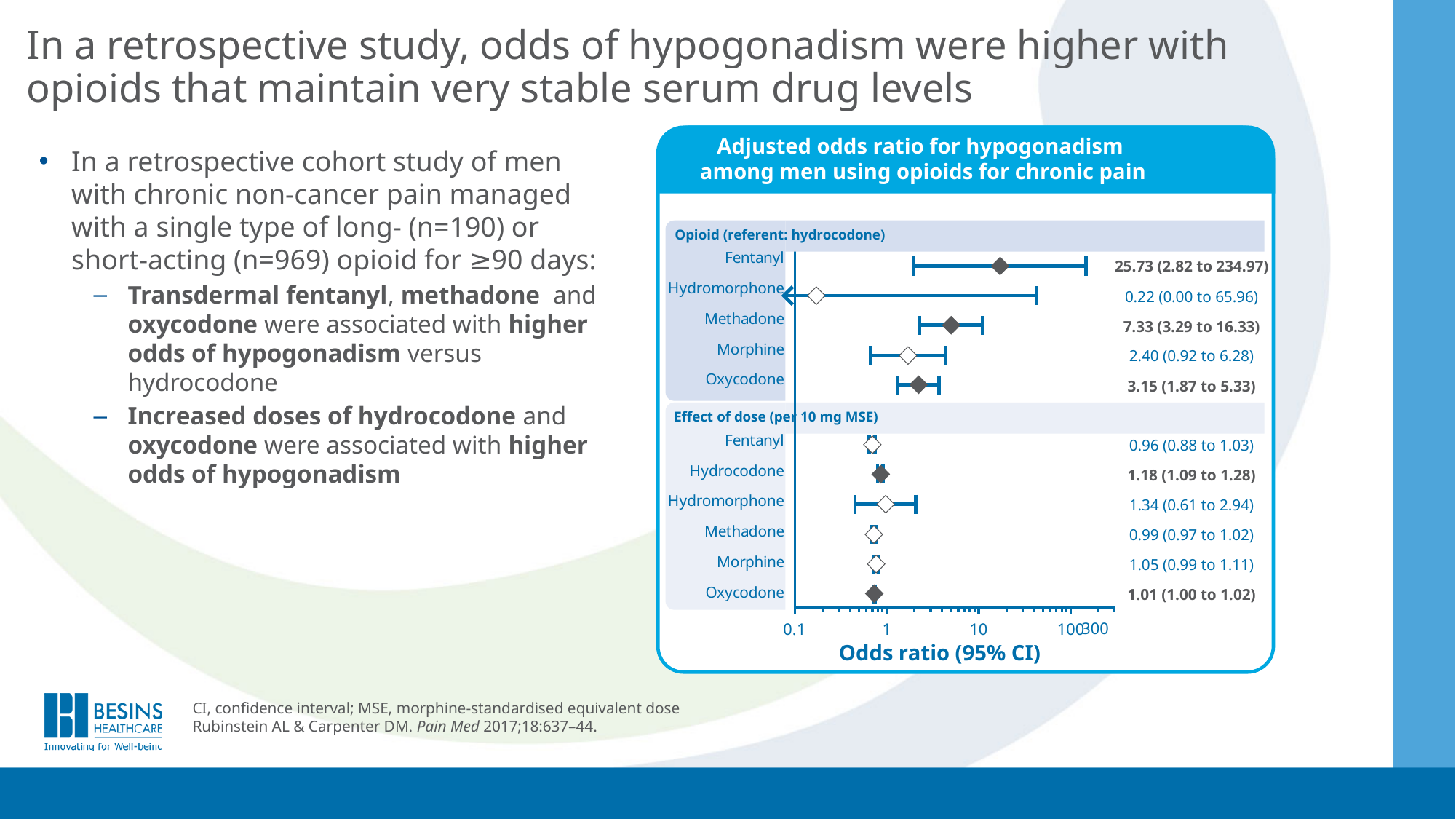
What is the difference between the odds ratios for methadone and oxycodone in the 'Opioid (referent: hydrocodone)' section? 4.18 How many opioids are listed in the 'Opioid (referent: hydrocodone)' section of the chart? 5 How many drugs are listed in the 'Effect of dose (per 10 mg MSE)' section of the chart? 6 What is the odds ratio shown for hydrocodone in the 'Effect of dose (per 10 mg MSE)' section? 1.18 What is the adjusted odds ratio for hypogonadism for fentanyl in the 'Opioid (referent: hydrocodone)' section? 25.73 What is the 95% confidence interval shown for methadone in the 'Opioid (referent: hydrocodone)' section? 3.29 to 16.33 Which opioid has the lowest adjusted odds ratio in the 'Opioid (referent: hydrocodone)' section? Hydromorphone Which drug has the highest odds ratio in the 'Effect of dose (per 10 mg MSE)' section? Hydromorphone What is the odds ratio and 95% CI shown for oxycodone in the 'Effect of dose (per 10 mg MSE)' section? 1.01 (1.00 to 1.02) Which opioid has the highest adjusted odds ratio in the 'Opioid (referent: hydrocodone)' section? Fentanyl In the 'Opioid (referent: hydrocodone)' section, which has the larger odds ratio, methadone or oxycodone? Methadone What is the label of the x axis of the chart? Odds ratio (95% CI)